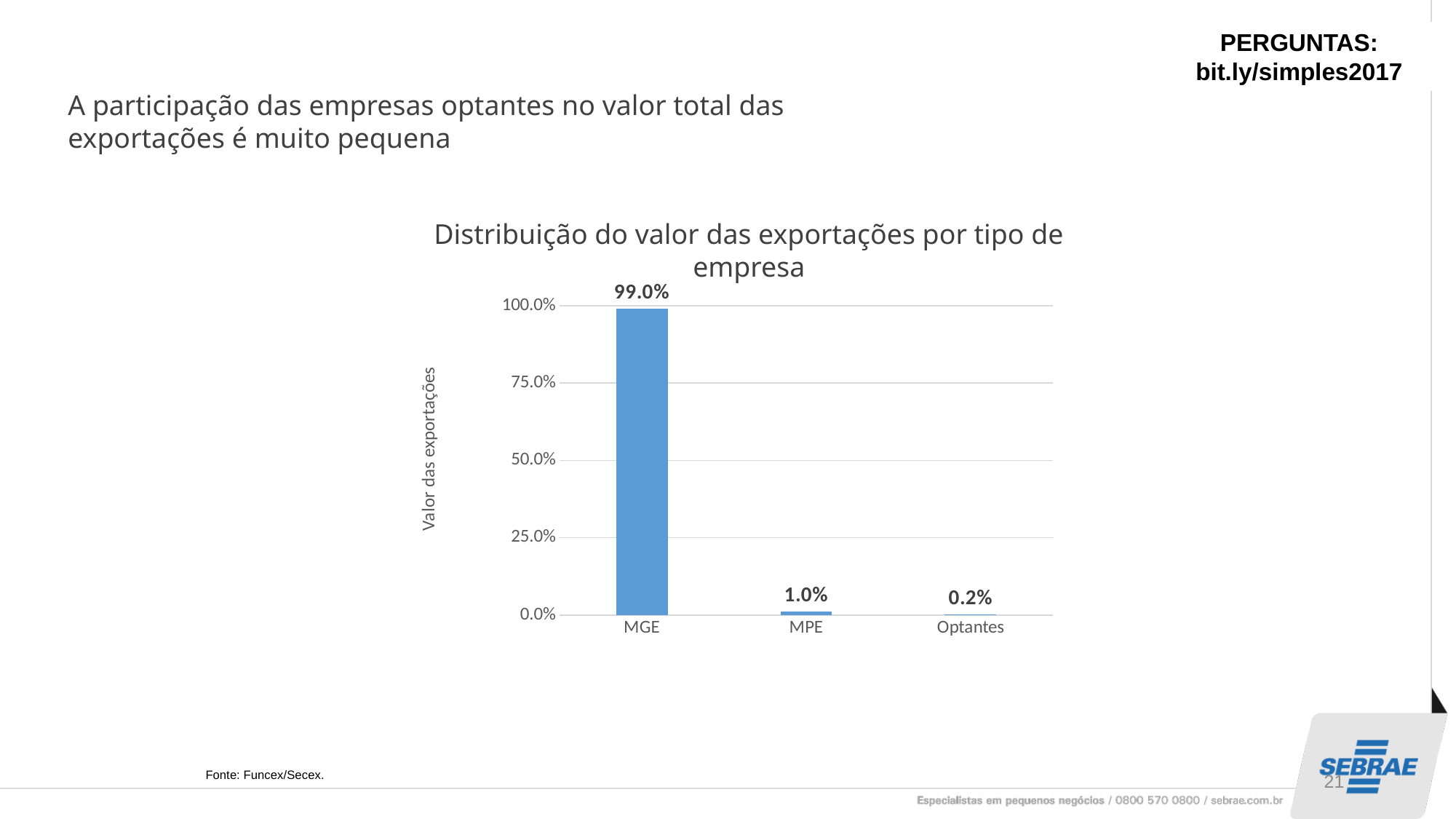
Which is larger, the value for MPE or the value for Optantes? MPE What is the difference between the values for MGE and MPE? 98.0% What is the value for MPE? 1.0% How many categories are shown on the x axis? 3 What is the value for Optantes? 0.2% Which category has the highest value? MGE What is the title of the chart? Distribuição do valor das exportações por tipo de empresa What is the difference between the values for MPE and Optantes? 0.8% Which category has the lowest value? Optantes What kind of chart is shown on the slide? bar chart What is the value for MGE? 99.0% Is the value for MGE greater or less than 75.0%? greater